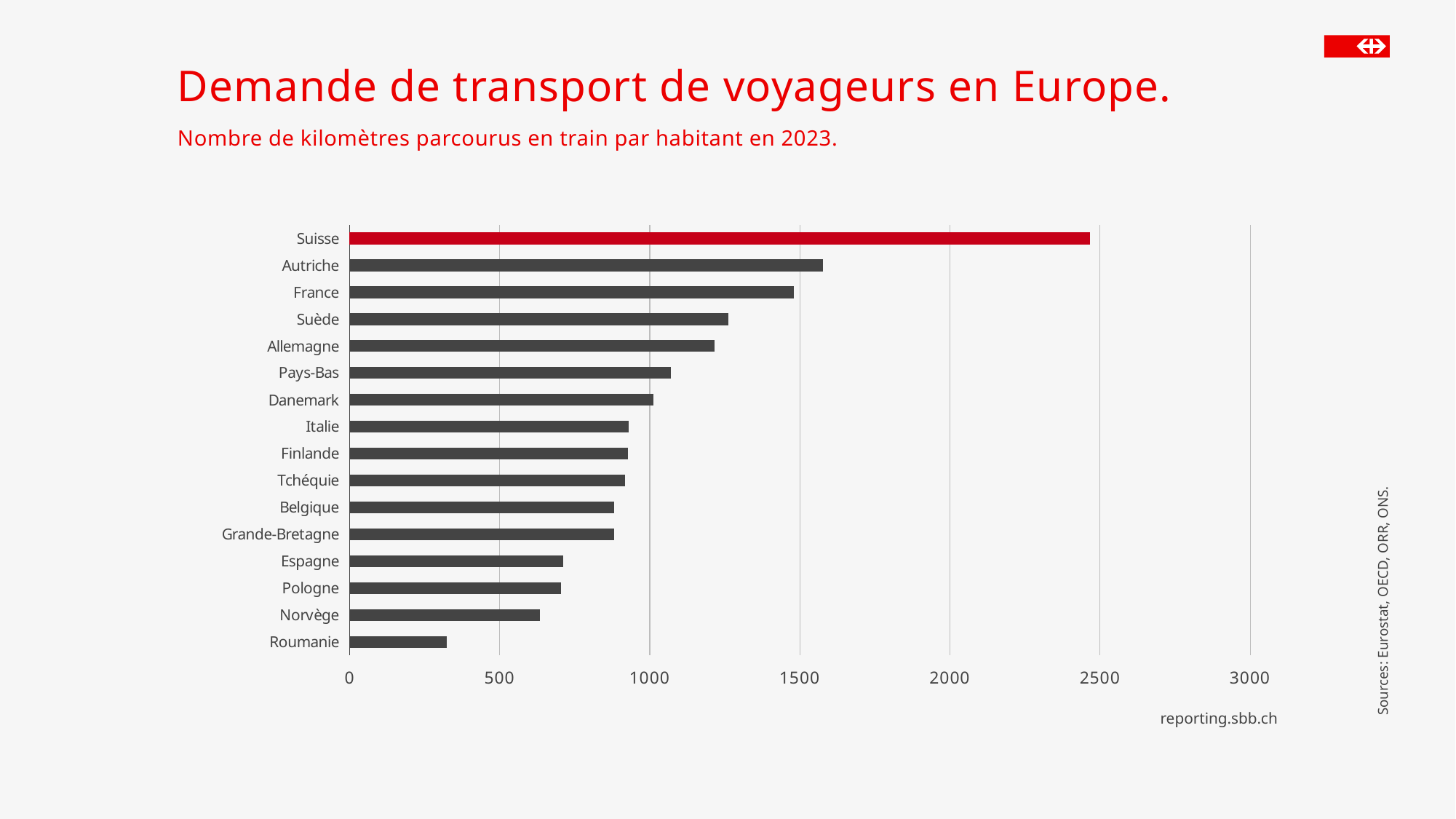
Which country's bar is highlighted in red? Suisse Is the value for Suisse greater or less than 2000? greater How many countries are shown in the chart? 16 Is the value for Allemagne greater or less than 1000? greater Which has a higher value, Norvège or Roumanie? Norvège Which country has the lowest number of kilometres travelled by train per inhabitant? Roumanie What kind of chart is shown on the slide? bar chart Is the value for Roumanie greater or less than 500? less Which country has the highest number of kilometres travelled by train per inhabitant? Suisse Which has a higher value, Autriche or France? Autriche